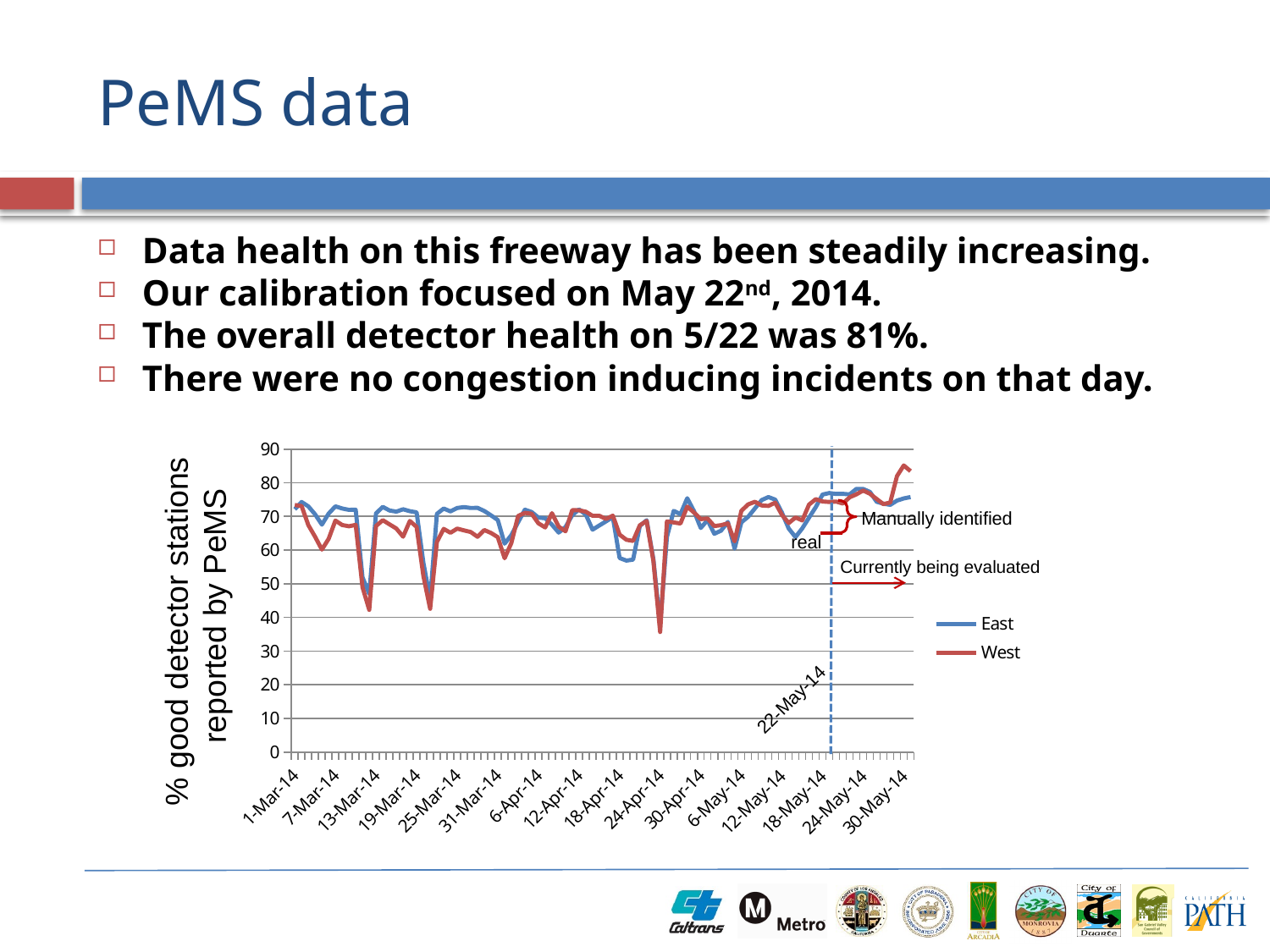
Does the West series end higher or lower at 30-May-14 than it starts at 1-Mar-14? higher What is the last date label on the chart's horizontal axis? 30-May-14 Is the West series value at its dip near 13-Mar-14 greater or less than 50? less Is the East series value at 1-Mar-14 greater or less than 60? greater Is the lowest value of the West series (the dip near 24-Apr-14) greater or less than 40? less What are the two series named in the chart legend? East and West What is the first date label on the chart's horizontal axis? 1-Mar-14 How many series does the chart's legend list? 2 What kind of chart is shown on the slide? line chart What is the label on the chart's vertical axis? % good detector stations reported by PeMS What is the highest value shown on the chart's vertical axis? 90 At the right end of the chart (after 24-May-14), which series reaches the higher value, East or West? West